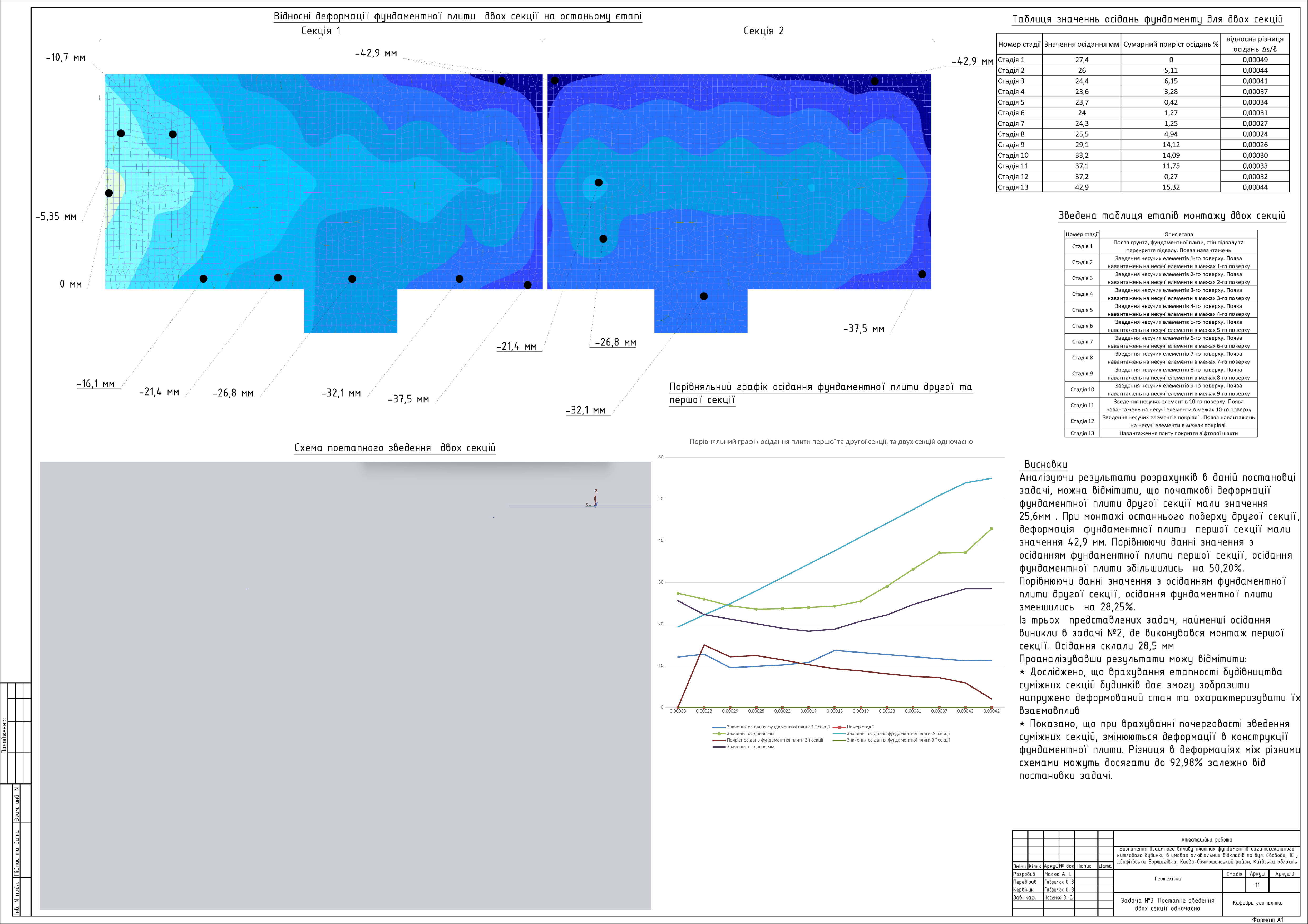
In the comparative settlement line chart, is the last value of the green series 'Значення осідання мм' greater or less than 40? greater In the comparative settlement line chart, does the series 'Значення осідання фундаментної плити 2-ї секції' rise or fall along the x axis? rise In the comparative settlement line chart, which series reaches the highest value at the last x-axis point? Значення осідання фундаментної плити 2-ї секції In the comparative settlement line chart, is the first value of the series 'Значення осідання фундаментної плити 1-ї секції' greater or less than 20? less What is the first label on the x axis of the comparative settlement line chart? 0.00033 What is the highest tick value shown on the y axis of the comparative settlement line chart? 60 In the comparative settlement line chart, is the last value of the series 'Значення осідання фундаментної плити 2-ї секції' greater or less than 50? greater How many series does the legend of the comparative settlement line chart list? 7 How many points are plotted along the x axis of the comparative settlement line chart? 13 In the comparative settlement line chart, at the last x-axis point, which is higher: the series 'Значення осідання фундаментної плити 2-ї секції' or the series 'Значення осідання фундаментної плити 1-ї секції'? Значення осідання фундаментної плити 2-ї секції What kind of chart is the 'Порівняльний графік осідання плити першої та другої секції, та двох секцій одночасно' chart? line chart